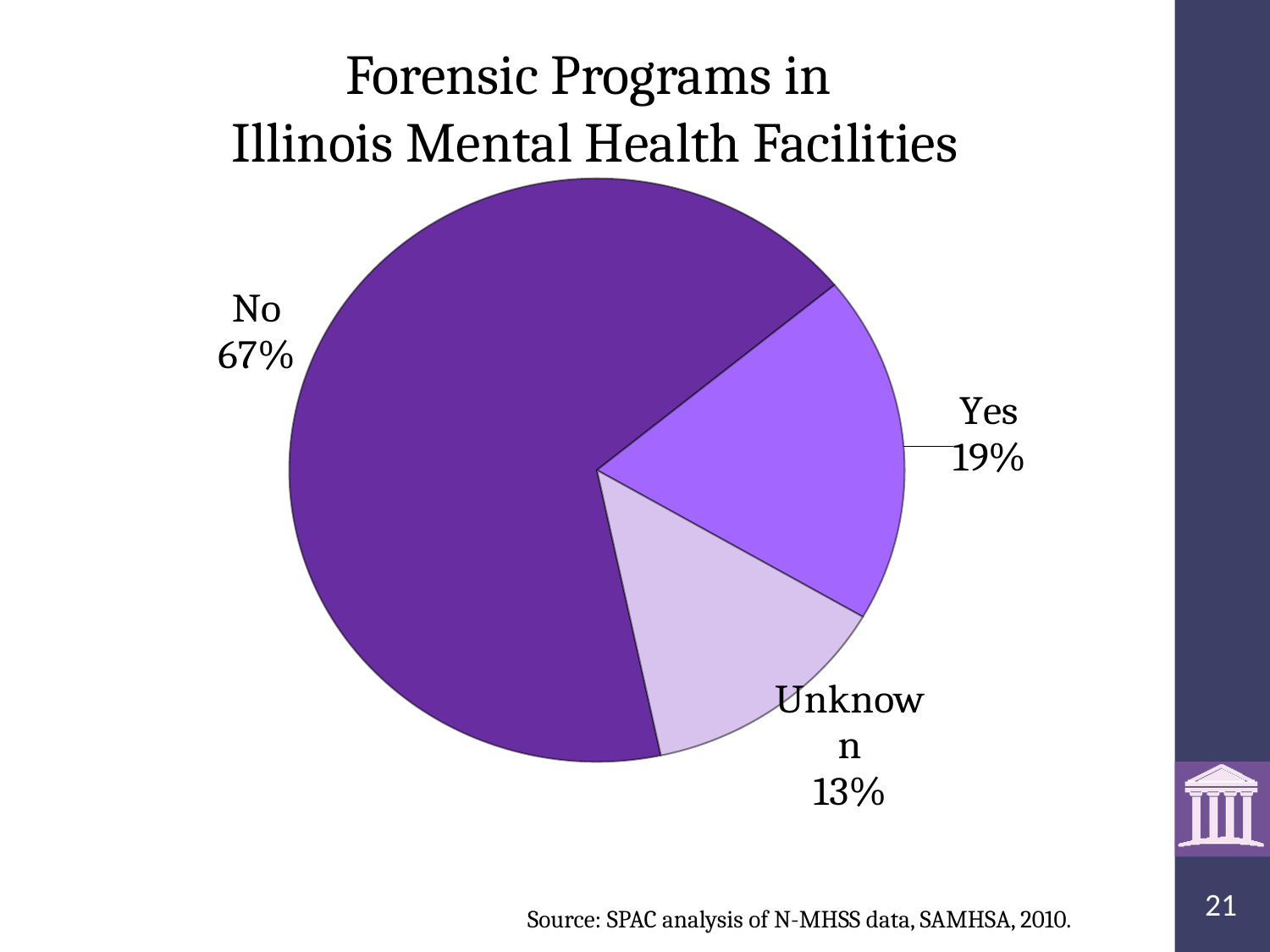
What percentage is labelled "Unknown"? 13% What is the title of the chart? Forensic Programs in Illinois Mental Health Facilities What is the source cited below the chart? SPAC analysis of N-MHSS data, SAMHSA, 2010. What percentage of facilities answered "No"? 67% What kind of chart is shown on the slide? pie chart What percentage of facilities answered "Yes"? 19% Which slice of the pie is the largest? No Which is larger, the "Yes" slice or the "Unknown" slice? Yes Which slice of the pie is the smallest? Unknown What is the difference in percentage points between the "No" and "Yes" slices? 48 How many slices does the pie chart have? 3 What is the difference in percentage points between the "Yes" and "Unknown" slices? 6